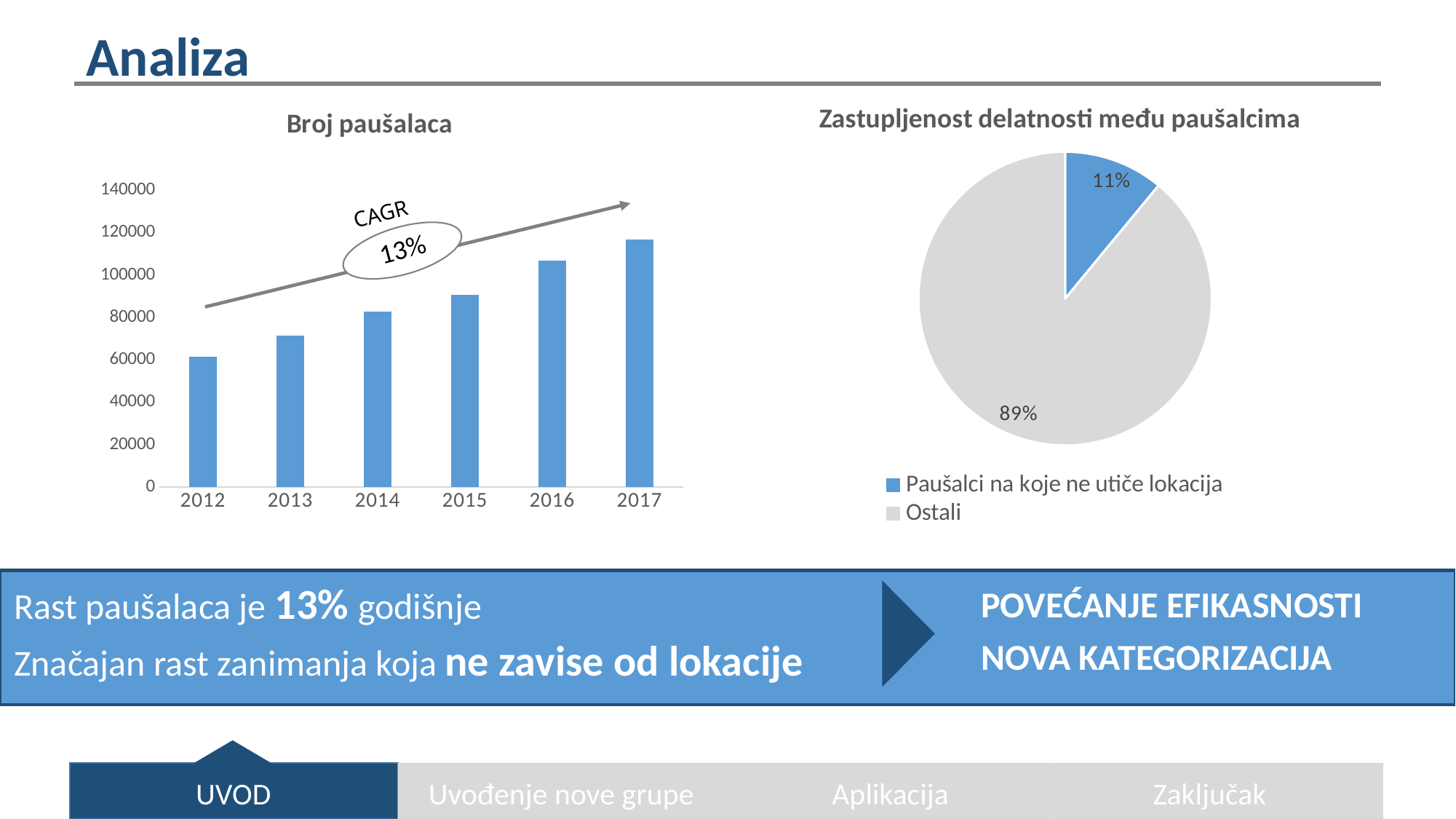
In the "Broj paušalaca" chart, do the values rise or fall from 2012 to 2017? rise What type of chart is the "Zastupljenost delatnosti među paušalcima" chart? pie chart In the "Broj paušalaca" chart, how many years are shown on the x axis? 6 In the "Broj paušalaca" chart, which year has the lowest value? 2012 In the "Broj paušalaca" chart, which is larger, the value for 2014 or the value for 2016? 2016 In the "Zastupljenost delatnosti među paušalcima" pie chart, how many entries does the legend list? 2 In the "Broj paušalaca" chart, which year has the highest value? 2017 In the "Broj paušalaca" chart, is the value for 2015 greater or less than 100000? less In the "Broj paušalaca" chart, is the value for 2012 greater or less than 80000? less What type of chart is the "Broj paušalaca" chart? bar chart In the "Broj paušalaca" chart, is the value for 2017 greater or less than 100000? greater In the "Zastupljenost delatnosti među paušalcima" pie chart, what share is labelled for "Paušalci na koje ne utiče lokacija"? 11%